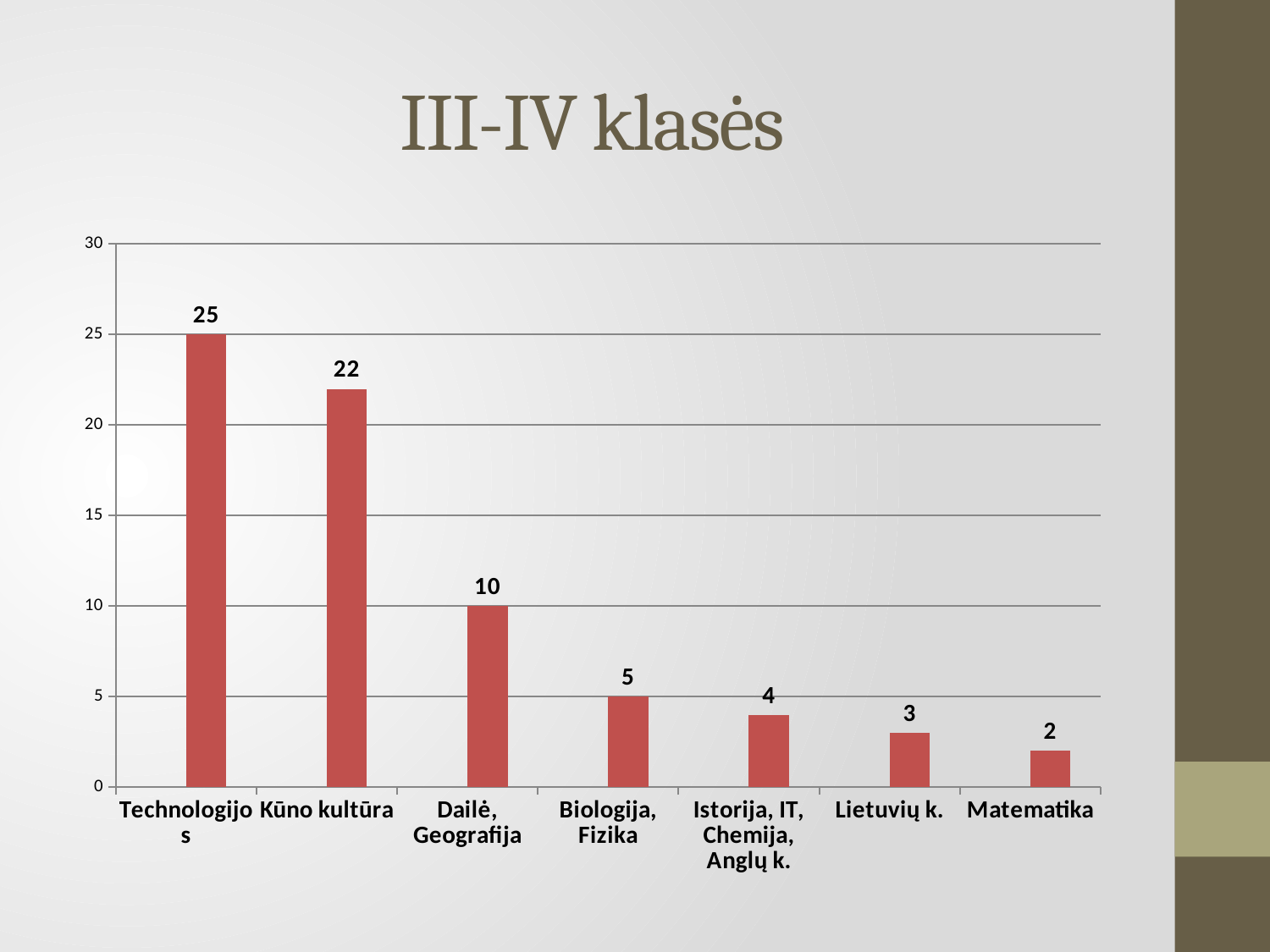
What kind of chart is shown on the slide? bar chart What is the title of the slide? III-IV klasės How many categories are shown on the chart? 7 What is the value for Dailė, Geografija? 10 What is the value for Lietuvių k.? 3 What is the difference between the values for Technologijos and Kūno kultūra? 3 Which category has the lowest value? Matematika What is the value for Kūno kultūra? 22 What is the value for Technologijos? 25 Which is larger, the value for Istorija, IT, Chemija, Anglų k. or the value for Lietuvių k.? Istorija, IT, Chemija, Anglų k. Which category has the highest value? Technologijos What is the difference between the values for Dailė, Geografija and Biologija, Fizika? 5